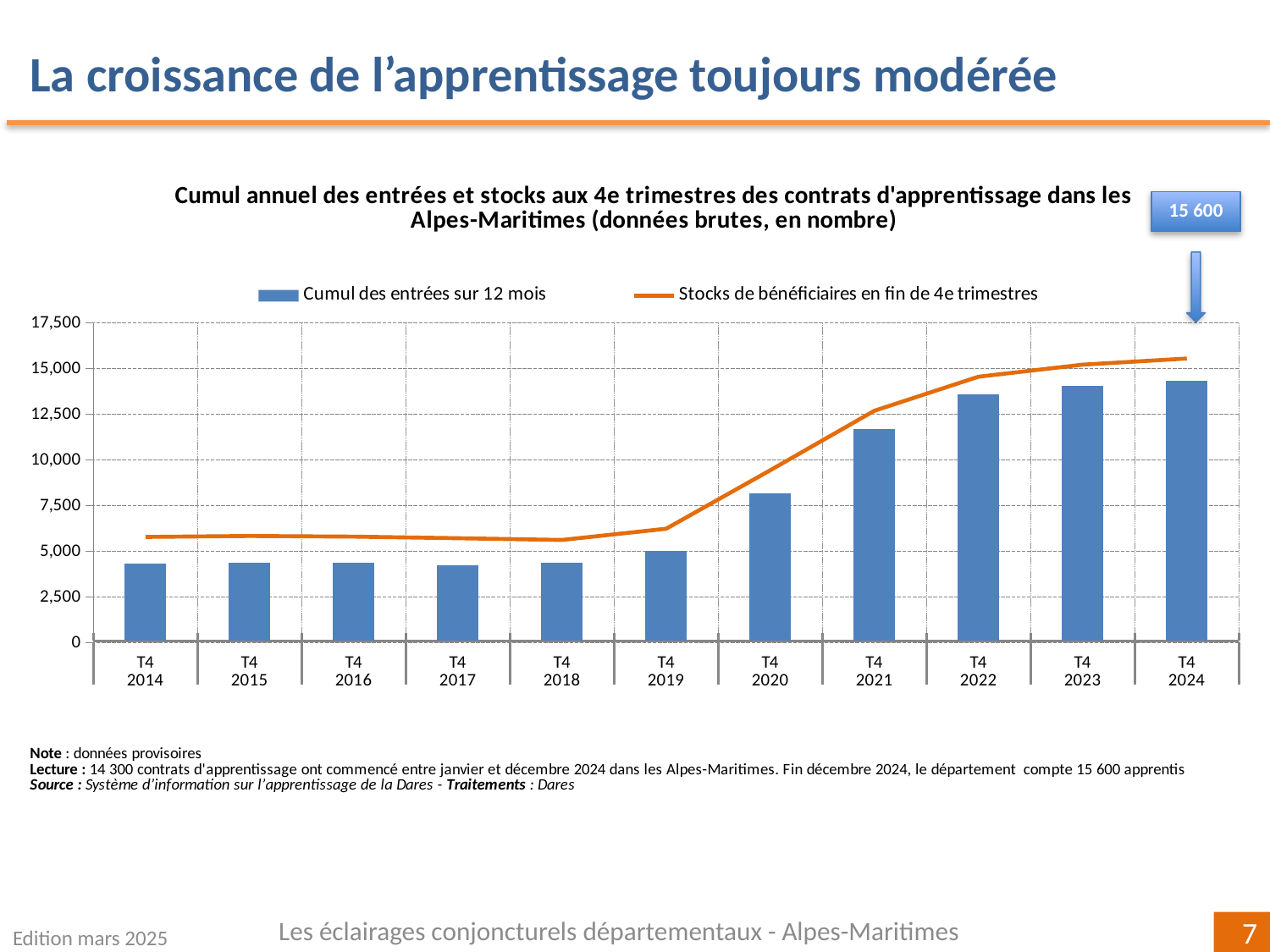
How many series does the chart legend list? 2 What is the difference between the stock of beneficiaries at T4 2024 (15 600) and the cumulative entries for 2024 (14 300)? 1 300 Does the 'Stocks de bénéficiaires en fin de 4e trimestres' line rise or fall between T4 2019 and T4 2024? It rises What colour is the line for 'Stocks de bénéficiaires en fin de 4e trimestres'? Orange Which is larger: the bar for T4 2021 or the bar for T4 2022? T4 2022 How many quarters (categories) are shown on the x axis? 11 Is the bar for T4 2020 greater or less than 7,500? greater According to the slide, how many apprenticeship contracts started between January and December 2024 (the T4 2024 bar)? 14 300 What is the value of the stock of beneficiaries at T4 2024, as shown in the callout? 15 600 Is the bar for T4 2018 greater or less than 5,000? less What kind of chart is shown on the slide? A combined bar and line chart Which quarter has the highest bar for 'Cumul des entrées sur 12 mois'? T4 2024